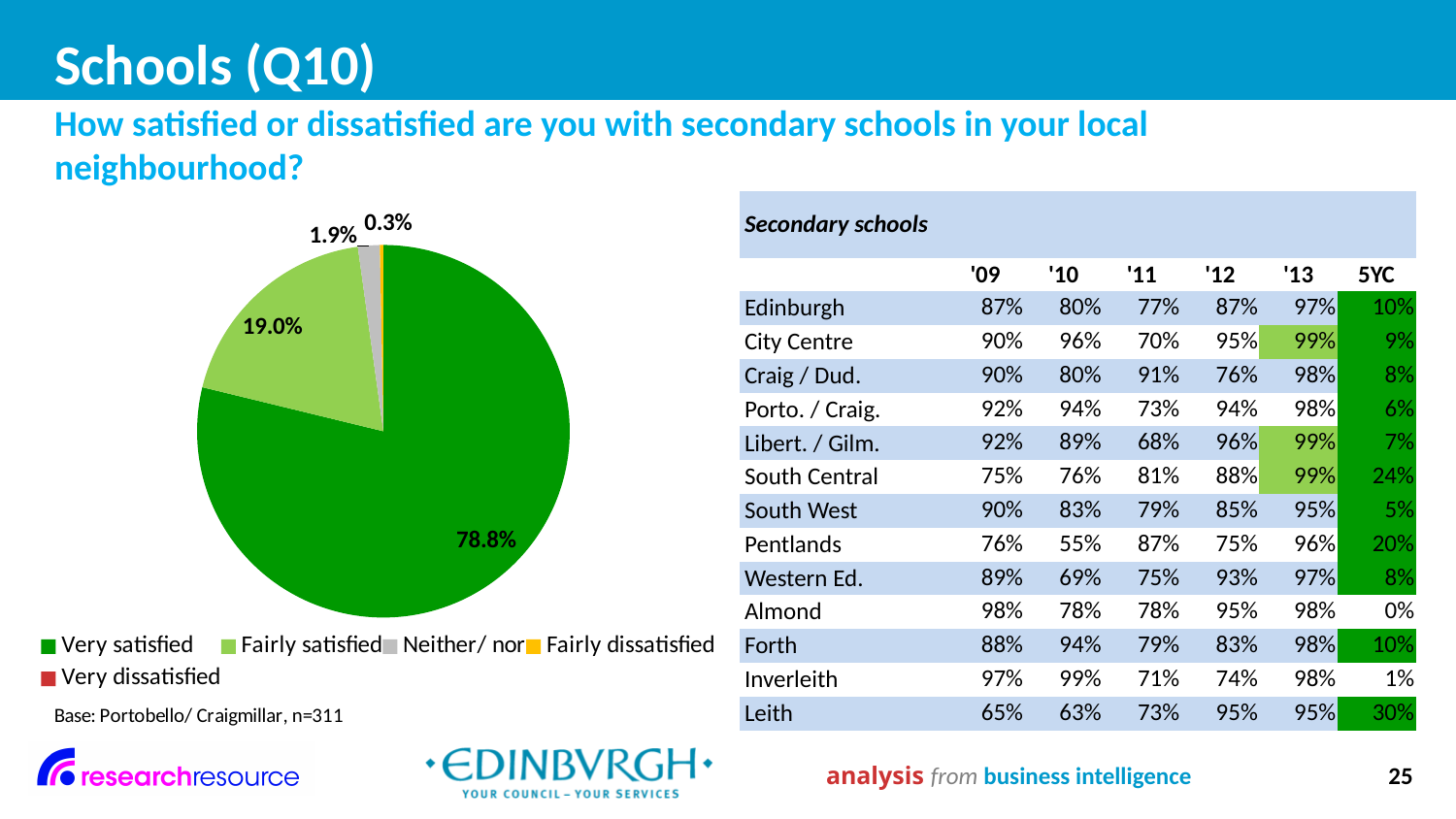
How many entries does the pie chart's legend list? 5 What share of the pie chart is 'Neither/ nor'? 1.9% What kind of chart is shown on the slide? pie chart What share of the pie chart is 'Very satisfied'? 78.8% What share of the pie chart is 'Fairly dissatisfied'? 0.3% Which of 'Fairly satisfied' or 'Neither/ nor' has the larger slice in the pie chart? Fairly satisfied What colour is the 'Very satisfied' slice in the pie chart? dark green What share of the pie chart is 'Fairly satisfied'? 19.0% What is the difference between the 'Very satisfied' and 'Fairly satisfied' shares in the pie chart? 59.8% What is the combined share of 'Very satisfied' and 'Fairly satisfied' in the pie chart? 97.8% What is the base (sample size) stated below the pie chart? Portobello/ Craigmillar, n=311 Which category has the largest slice of the pie chart? Very satisfied